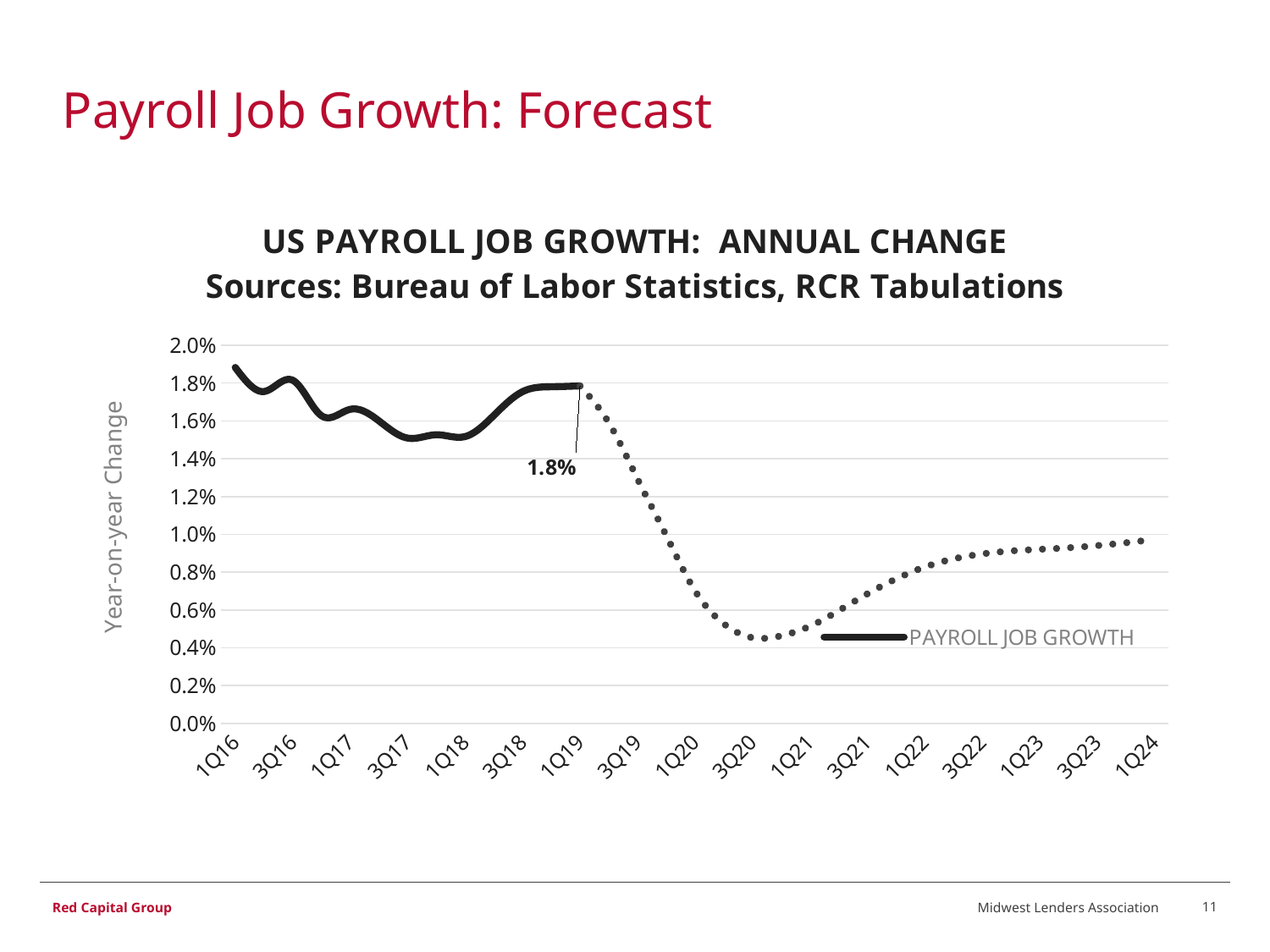
Is the value for 1Q16 greater or less than 1.6%? greater How many series does the legend list? 1 What kind of chart is shown on the slide? line chart Is the value for 3Q20 greater or less than 0.6%? less Is the value for 1Q18 greater or less than 1.6%? less What is the name of the series shown in the legend? PAYROLL JOB GROWTH What is the title of the vertical axis? Year-on-year Change Does the line rise or fall between 1Q19 and 3Q20? fall What is the labeled value of payroll job growth at 1Q19? 1.8% Does the line rise or fall between 3Q20 and 1Q24? rise